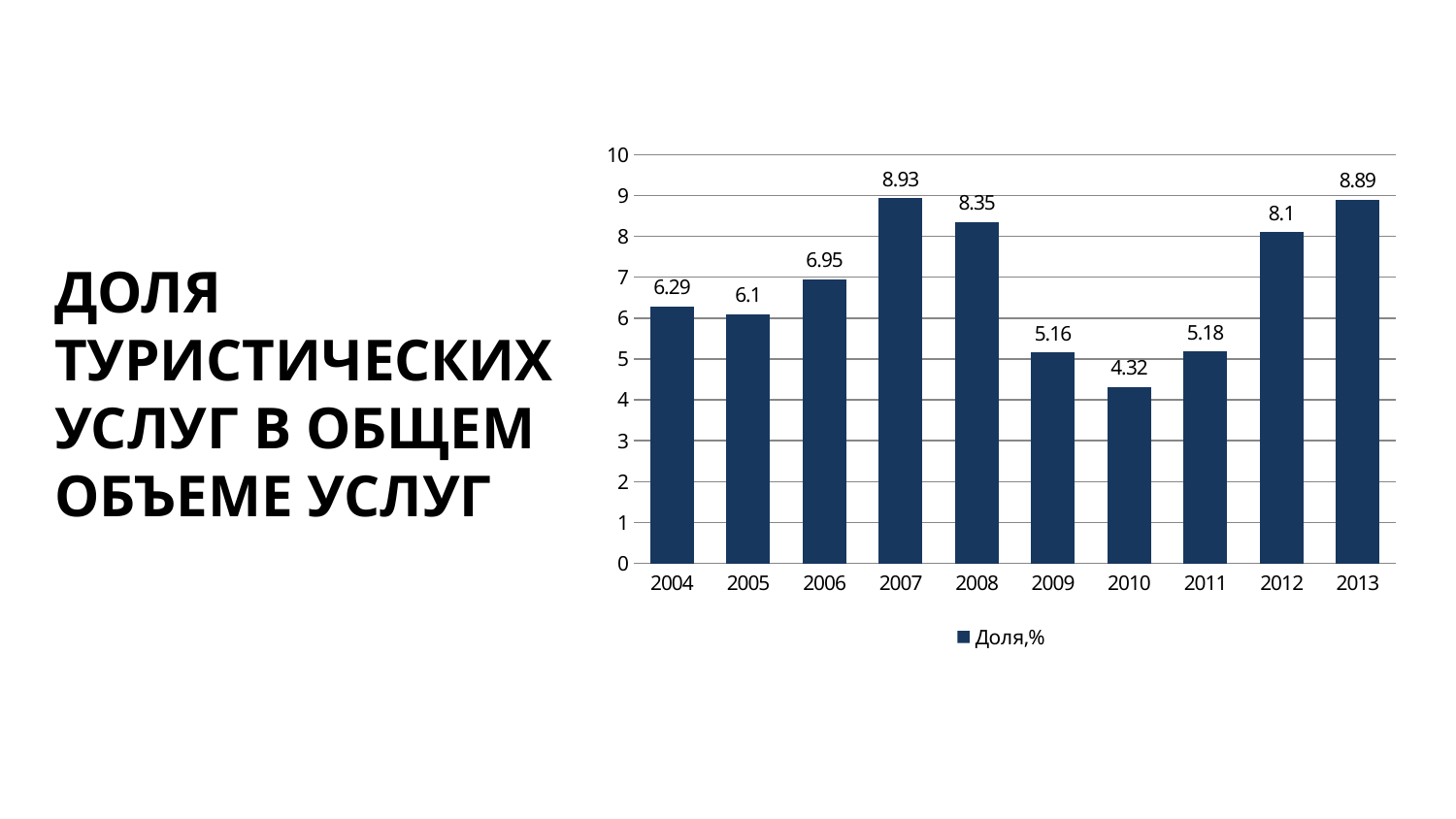
How many years are shown on the x axis? 10 What is the value for 2007? 8.93 Is the value for 2008 greater or less than 8? greater What is the difference between the values for 2013 and 2012? 0.79 Which is larger, the value for 2004 or the value for 2005? 2004 What is the value for 2012? 8.1 What is the legend entry for the series? Доля,% Which year has the lowest value? 2010 What kind of chart is shown on the slide? bar chart How many series does the legend list? 1 What is the value for 2010? 4.32 Which year has the highest value? 2007